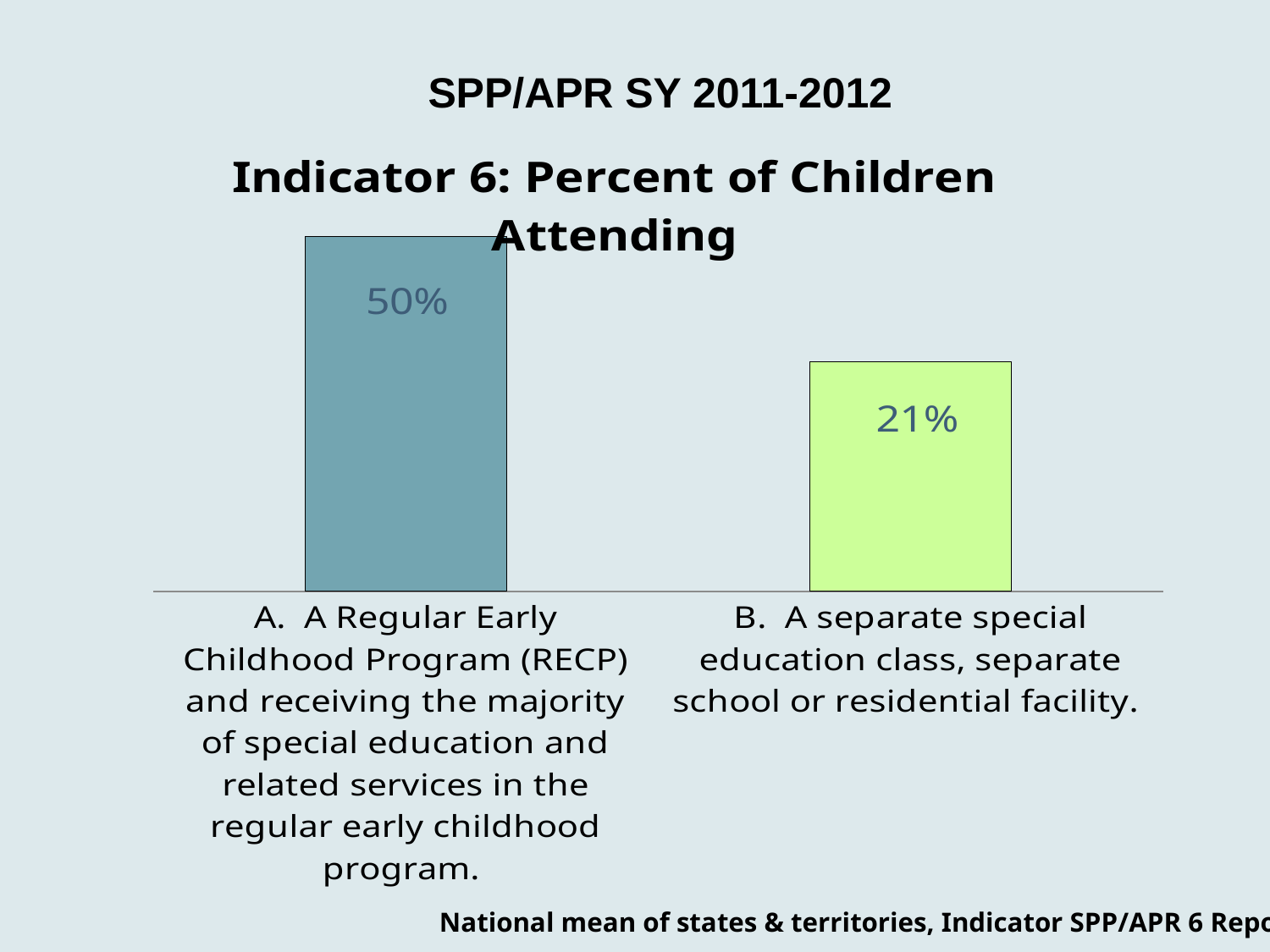
Which category has the highest value? A. A Regular Early Childhood Program (RECP) How many categories are shown in the chart? 2 What is the difference between the values for category A and category B? 29% Which category has the lowest value? B. A separate special education class, separate school or residential facility What is the value for category B (A separate special education class, separate school or residential facility)? 21% Which is larger, the value for category A or category B? Category A What is the title of the chart? Indicator 6: Percent of Children Attending What kind of chart is shown on the slide? Bar chart What colour is the bar for category B? Light green What is the value for category A (A Regular Early Childhood Program)? 50%